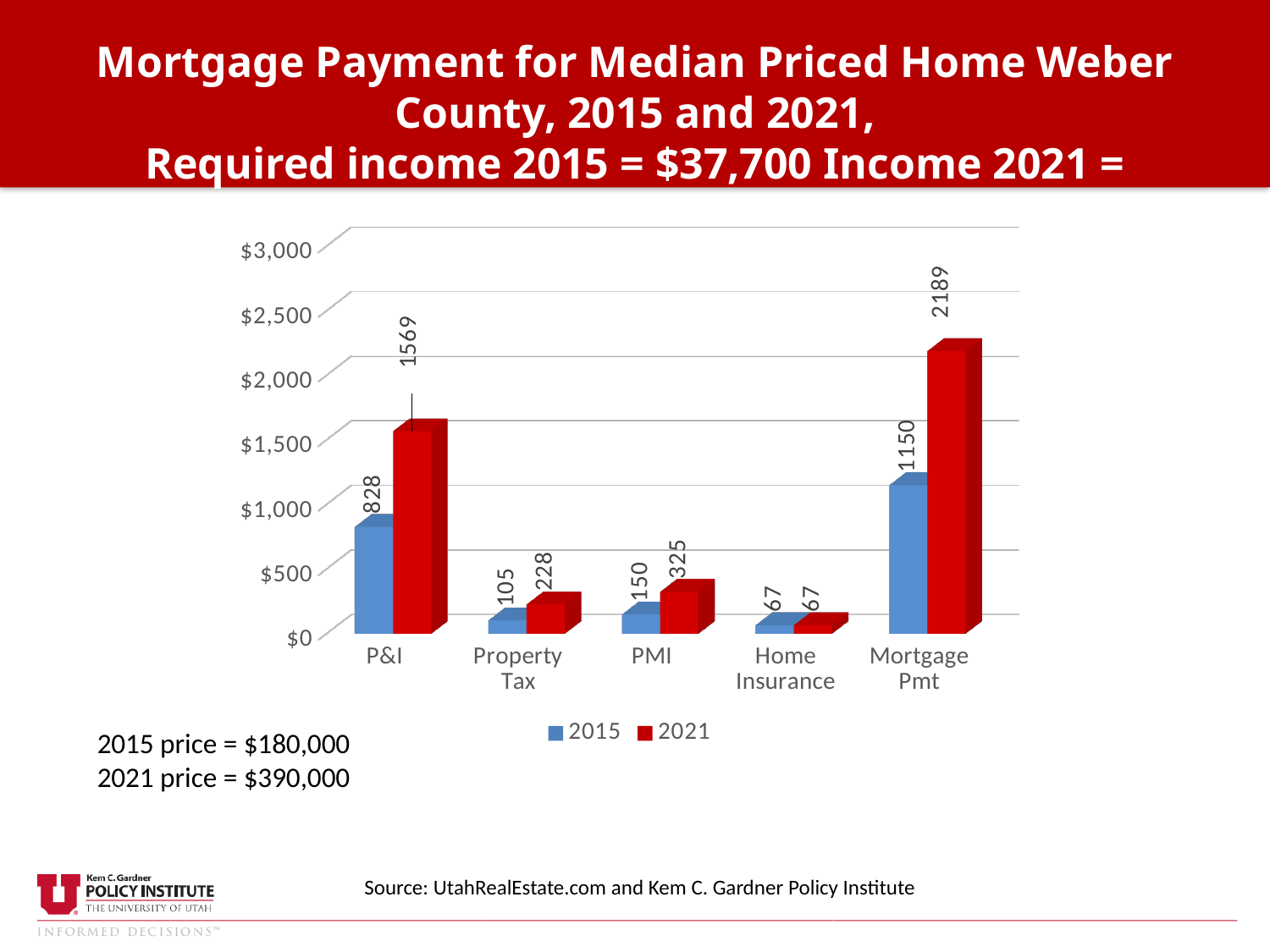
How many series does the legend list? 2 What is the 2021 value for PMI? 325 Which category has the highest 2021 value? Mortgage Pmt Which is larger, the 2021 value for Property Tax or the 2021 value for PMI? PMI What is the 2015 value for Property Tax? 105 What is the difference between the 2021 and 2015 values for Mortgage Pmt? 1039 What is the 2021 value for P&I? 1569 Is the 2021 value for P&I greater or less than $1,000? greater What kind of chart is shown on the slide? bar chart What is the 2015 value for Mortgage Pmt? 1150 Which category has the lowest 2015 value? Home Insurance How many categories are shown on the x axis? 5